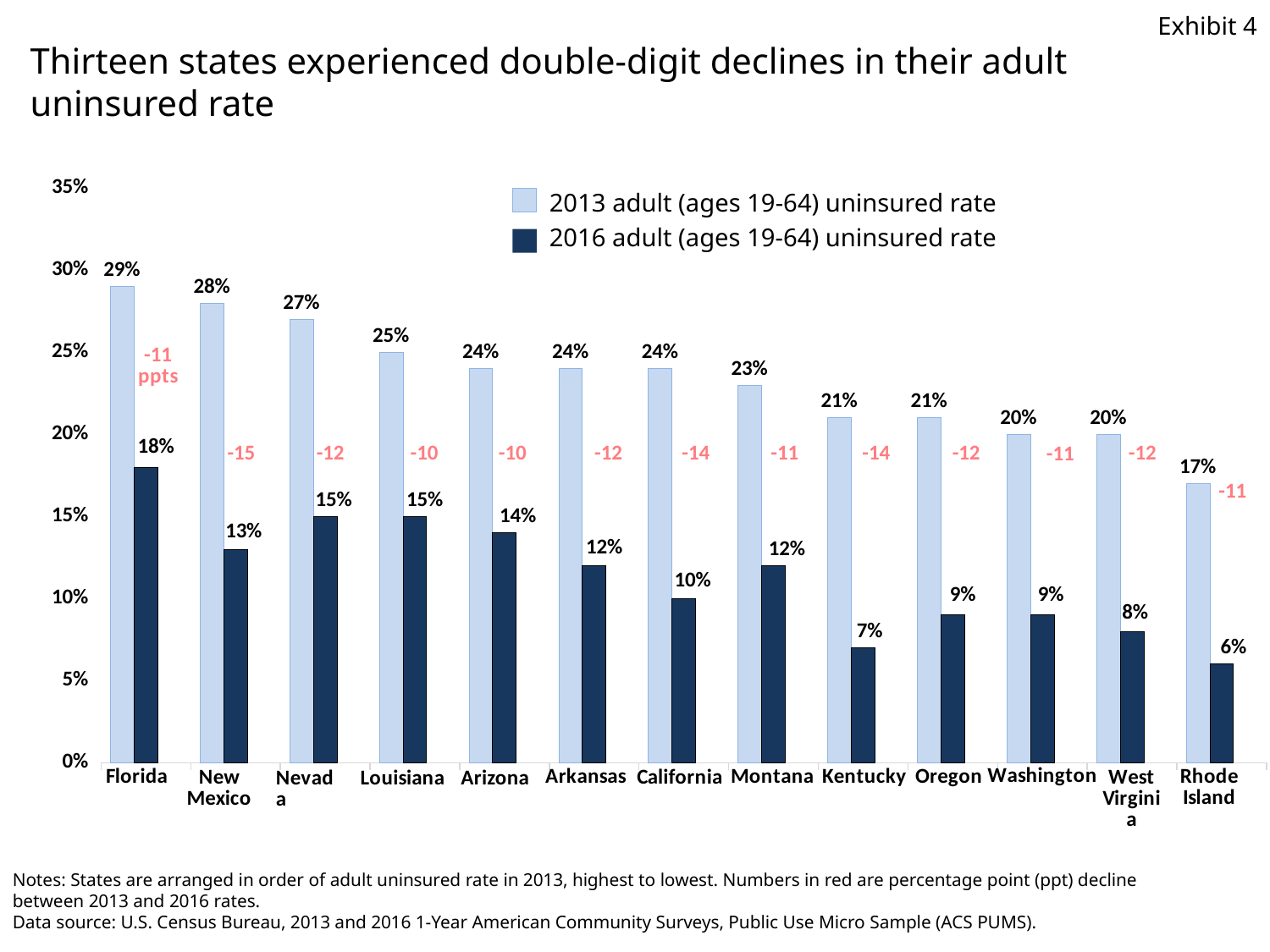
What do the red numbers on the chart represent? Percentage point decline between 2013 and 2016 rates Which state had a higher 2016 adult uninsured rate, Arizona or California? Arizona What was Kentucky's 2016 adult (ages 19-64) uninsured rate? 7% Which state had the lowest 2016 adult uninsured rate? Rhode Island How many series does the legend list? 2 Do the 2013 adult uninsured rates rise or fall from left to right across the states? Fall What type of chart is shown on the slide? Bar chart What is the difference between New Mexico's 2013 and 2016 adult uninsured rates? 15 percentage points What was Florida's 2013 adult (ages 19-64) uninsured rate? 29% What was Rhode Island's 2016 adult uninsured rate? 6% Which state had the highest 2013 adult uninsured rate? Florida How many states are shown on the chart? 13